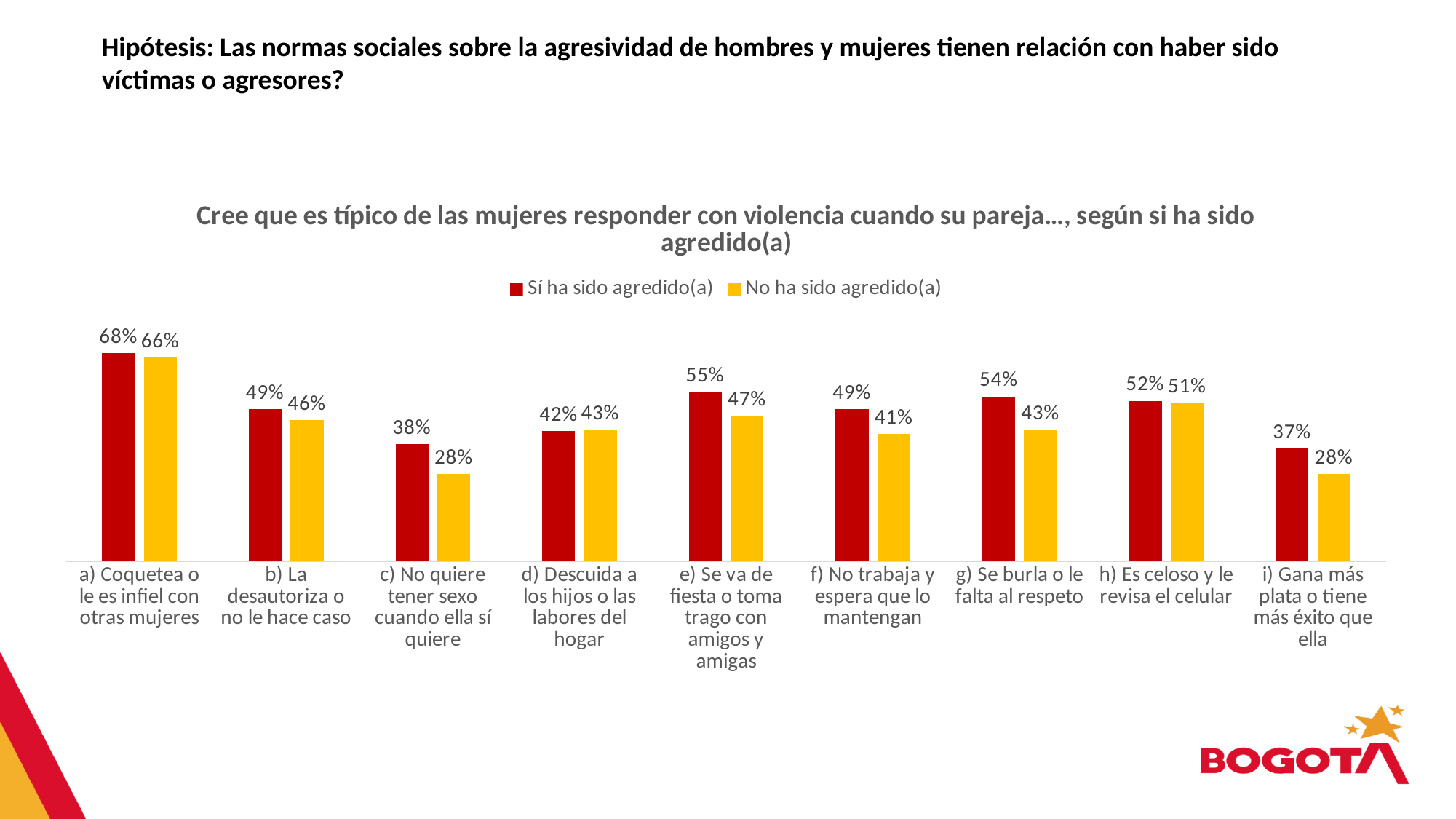
What is the difference between 'Sí ha sido agredido(a)' and 'No ha sido agredido(a)' for category c) No quiere tener sexo cuando ella sí quiere? 10% What is the value for 'Sí ha sido agredido(a)' for category e) Se va de fiesta o toma trago con amigos y amigas? 55% Which category has the lowest value for 'Sí ha sido agredido(a)'? i) Gana más plata o tiene más éxito que ella What is the value for 'Sí ha sido agredido(a)' for category a) Coquetea o le es infiel con otras mujeres? 68% Which category has the highest value for 'Sí ha sido agredido(a)'? a) Coquetea o le es infiel con otras mujeres How many categories are shown on the x axis? 9 What is the value for 'No ha sido agredido(a)' for category c) No quiere tener sexo cuando ella sí quiere? 28% For category d) Descuida a los hijos o las labores del hogar, which series has the larger value? No ha sido agredido(a) How many series does the legend list? 2 Which colour represents the series 'No ha sido agredido(a)'? Yellow What kind of chart is shown on the slide? Bar chart What is the difference between 'Sí ha sido agredido(a)' and 'No ha sido agredido(a)' for category g) Se burla o le falta al respeto? 11%